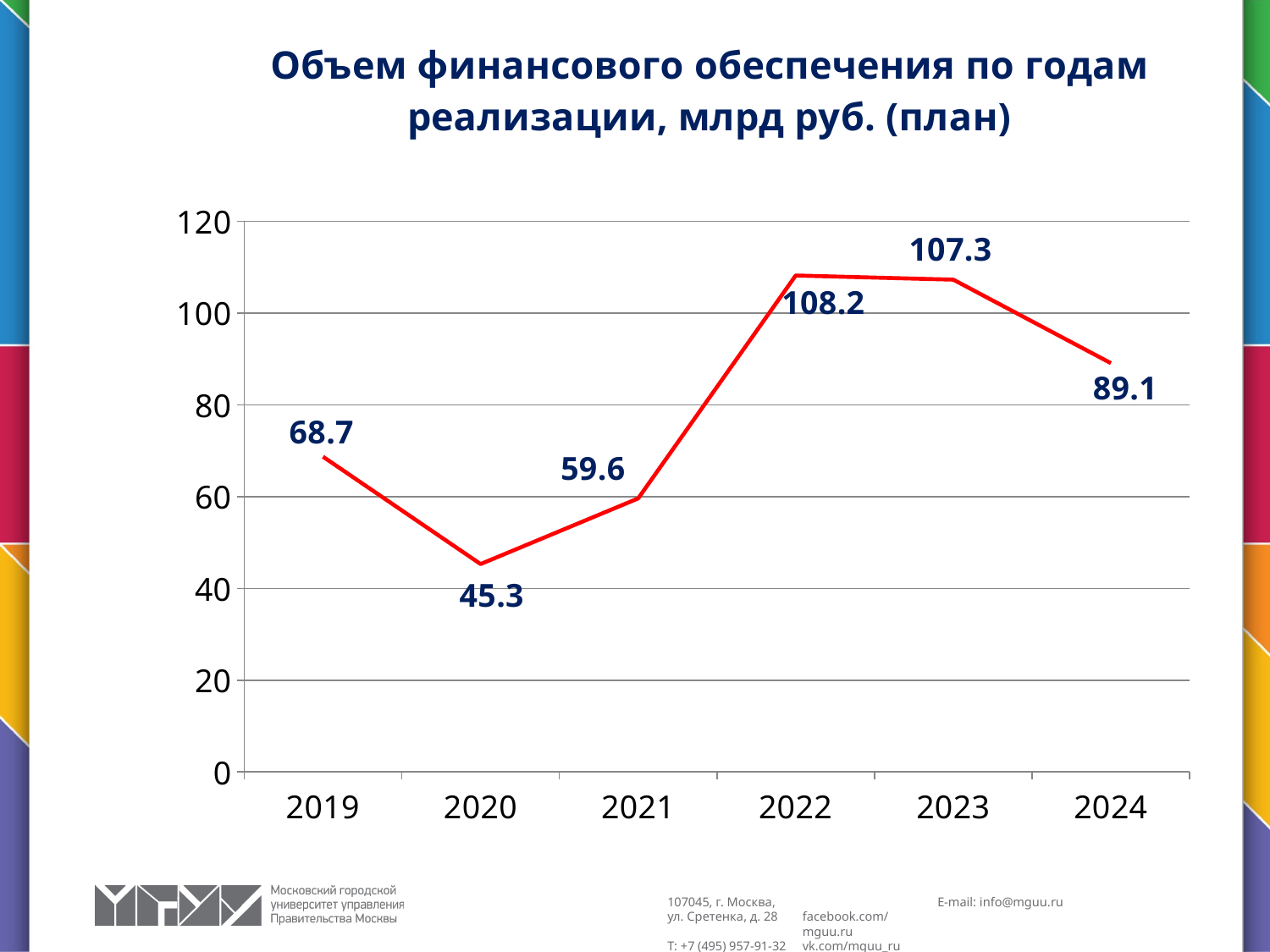
What is the difference between the values for 2019 and 2020? 23.4 Which year has the highest value? 2022 Which is larger, the value for 2019 or the value for 2021? 2019 Which year has the lowest value? 2020 What is the value for 2024? 89.1 How many years are plotted on the chart? 6 What is the value for 2022? 108.2 Does the value rise or fall from 2023 to 2024? fall Is the value for 2024 greater or less than 80? greater What kind of chart is shown on the slide? line chart What is the value for 2019? 68.7 What is the difference between the values for 2022 and 2021? 48.6